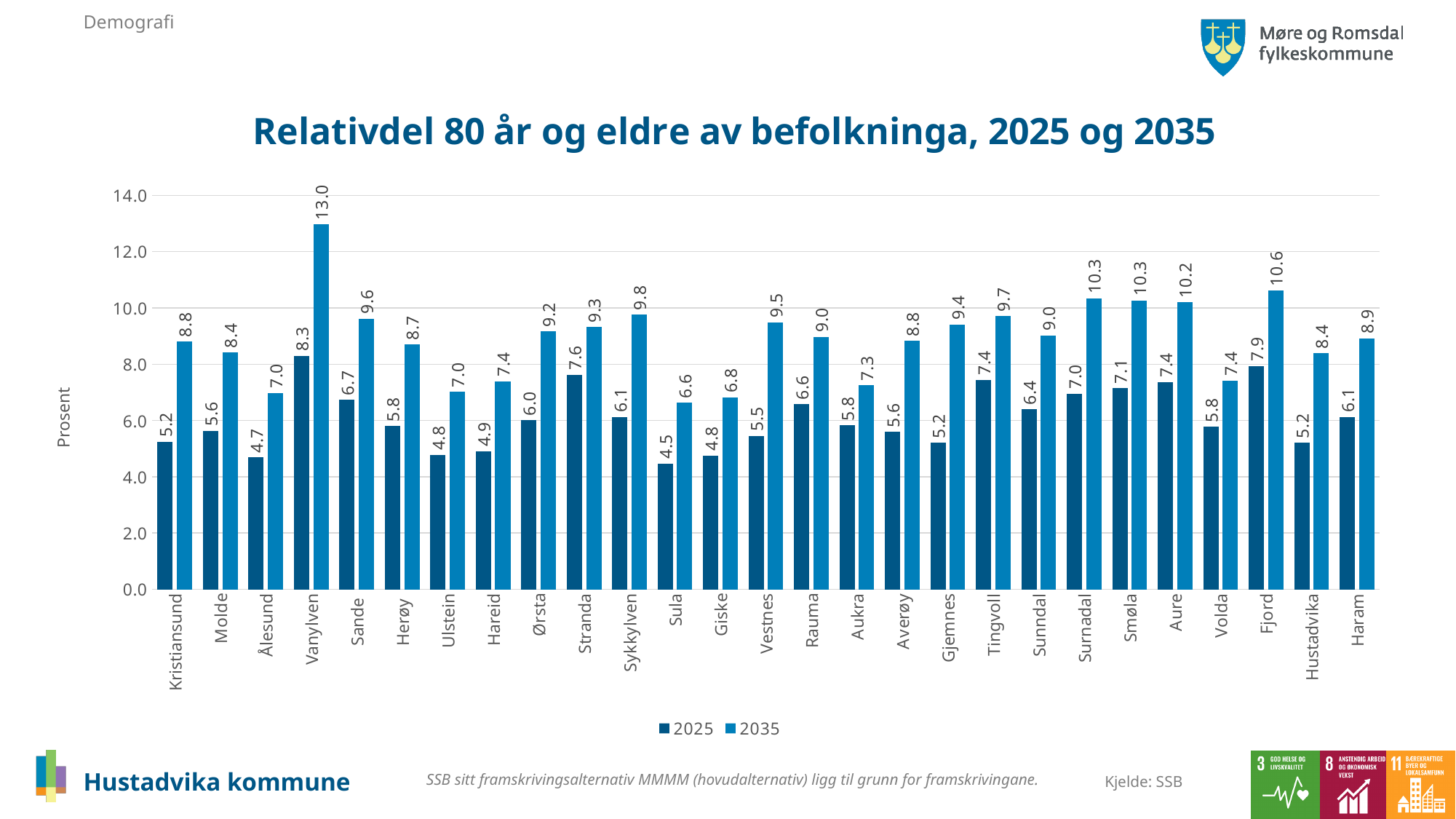
Which municipality has the lowest 2025 value? Sula What is the difference between the 2035 and 2025 values for Hustadvika? 3.2 How many municipalities are shown on the x axis? 27 What is the difference between the 2035 values for Vanylven and Fjord? 2.4 Which is larger, the 2025 value for Stranda or the 2025 value for Sunndal? Stranda What is the label on the y axis? Prosent What is the 2035 value for Fjord? 10.6 Which municipality has the highest 2035 value? Vanylven What is the 2025 value for Hustadvika? 5.2 What is the 2035 value for Vanylven? 13.0 How many series does the legend list? 2 What kind of chart is shown on the slide? Bar chart